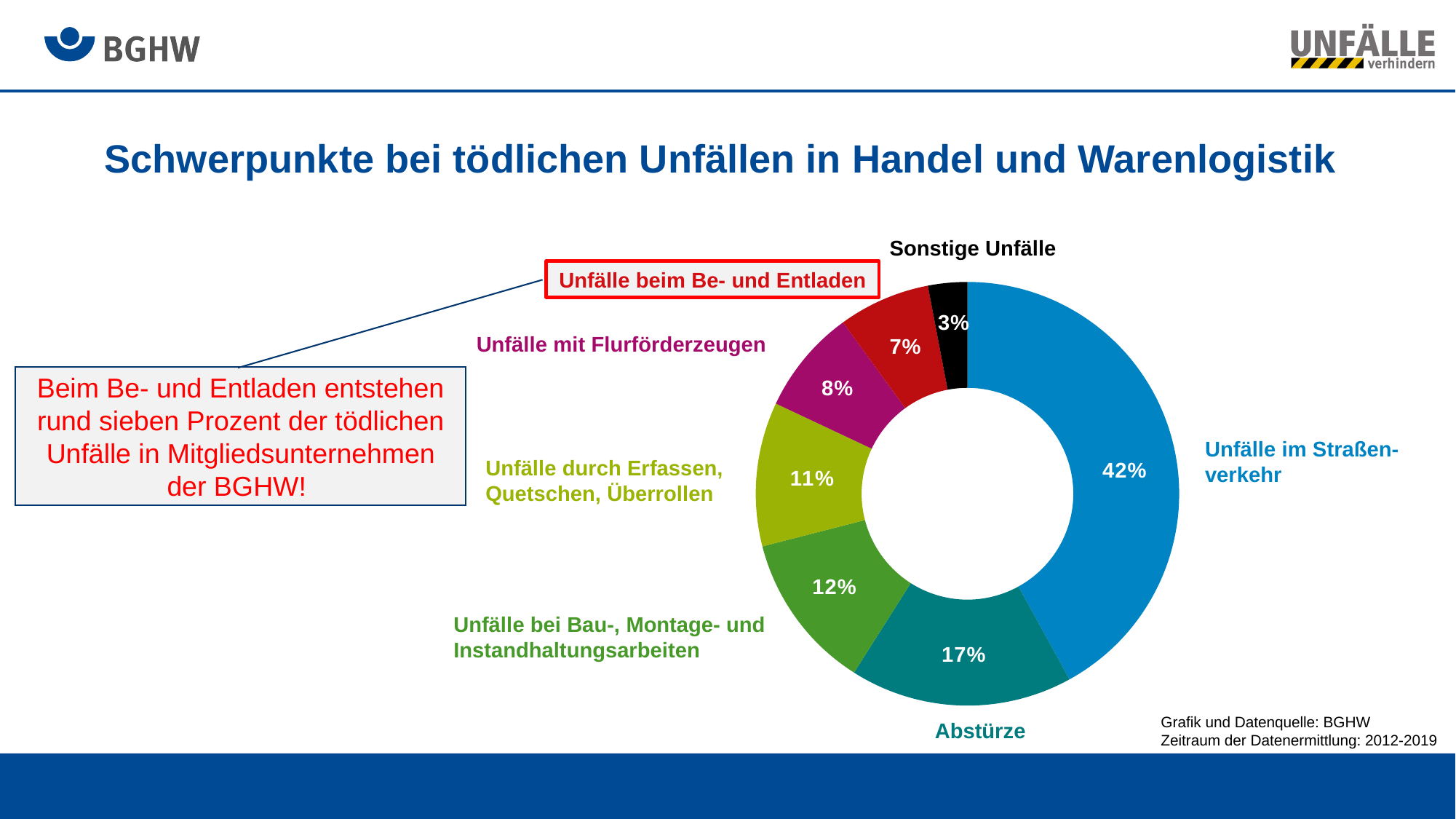
What is the combined share of 'Unfälle mit Flurförderzeugen' and 'Unfälle beim Be- und Entladen'? 15% What percentage is shown for 'Abstürze'? 17% Which category has the smallest share of the chart? Sonstige Unfälle What type of chart is shown on the slide? Doughnut (pie) chart Which category label is highlighted with a red box? Unfälle beim Be- und Entladen Which category has the largest share of the chart? Unfälle im Straßenverkehr What share of fatal accidents is attributed to 'Unfälle im Straßenverkehr'? 42% How many categories are shown in the chart? 7 Which is larger: the share for 'Unfälle bei Bau-, Montage- und Instandhaltungsarbeiten' or for 'Unfälle durch Erfassen, Quetschen, Überrollen'? Unfälle bei Bau-, Montage- und Instandhaltungsarbeiten What is the difference in percentage points between 'Unfälle im Straßenverkehr' and 'Abstürze'? 25 What percentage is shown for 'Unfälle beim Be- und Entladen'? 7% What percentage is shown for 'Unfälle mit Flurförderzeugen'? 8%